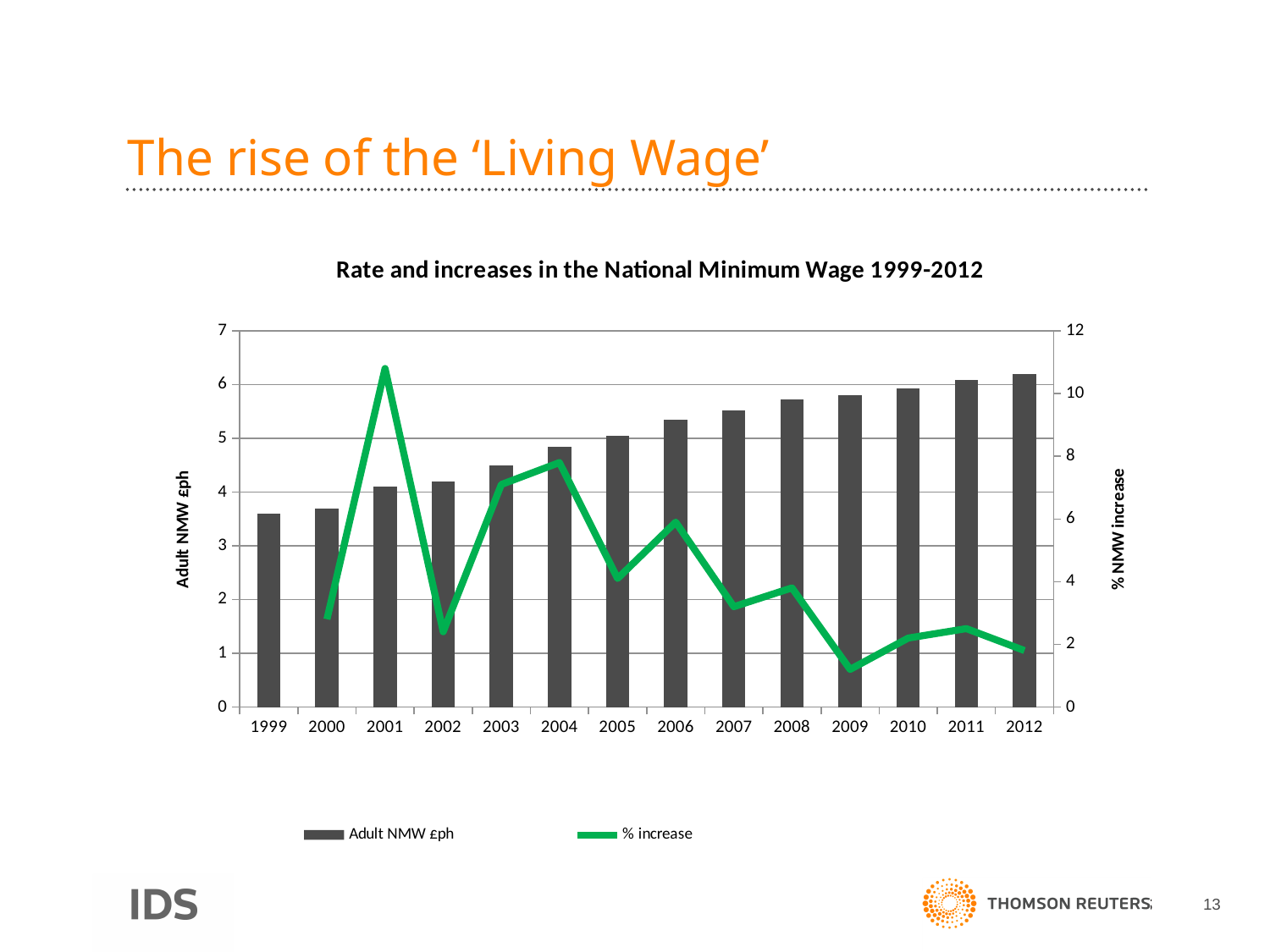
What is the title of the chart? Rate and increases in the National Minimum Wage 1999-2012 How many years are shown on the x axis? 14 Is the Adult NMW £ph value for 2012 greater or less than 6? greater Is the % increase for 2001 greater or less than 10? greater Which year has the highest % increase? 2001 Which year has the larger % increase, 2005 or 2006? 2006 How many series does the legend list? 2 Which year has the highest Adult NMW £ph bar? 2012 Do the Adult NMW £ph bars rise or fall from 1999 to 2012? Rise Which year has the lowest Adult NMW £ph bar? 1999 What kind of chart is shown on the slide? A combined bar and line chart Which year has the lowest % increase? 2009